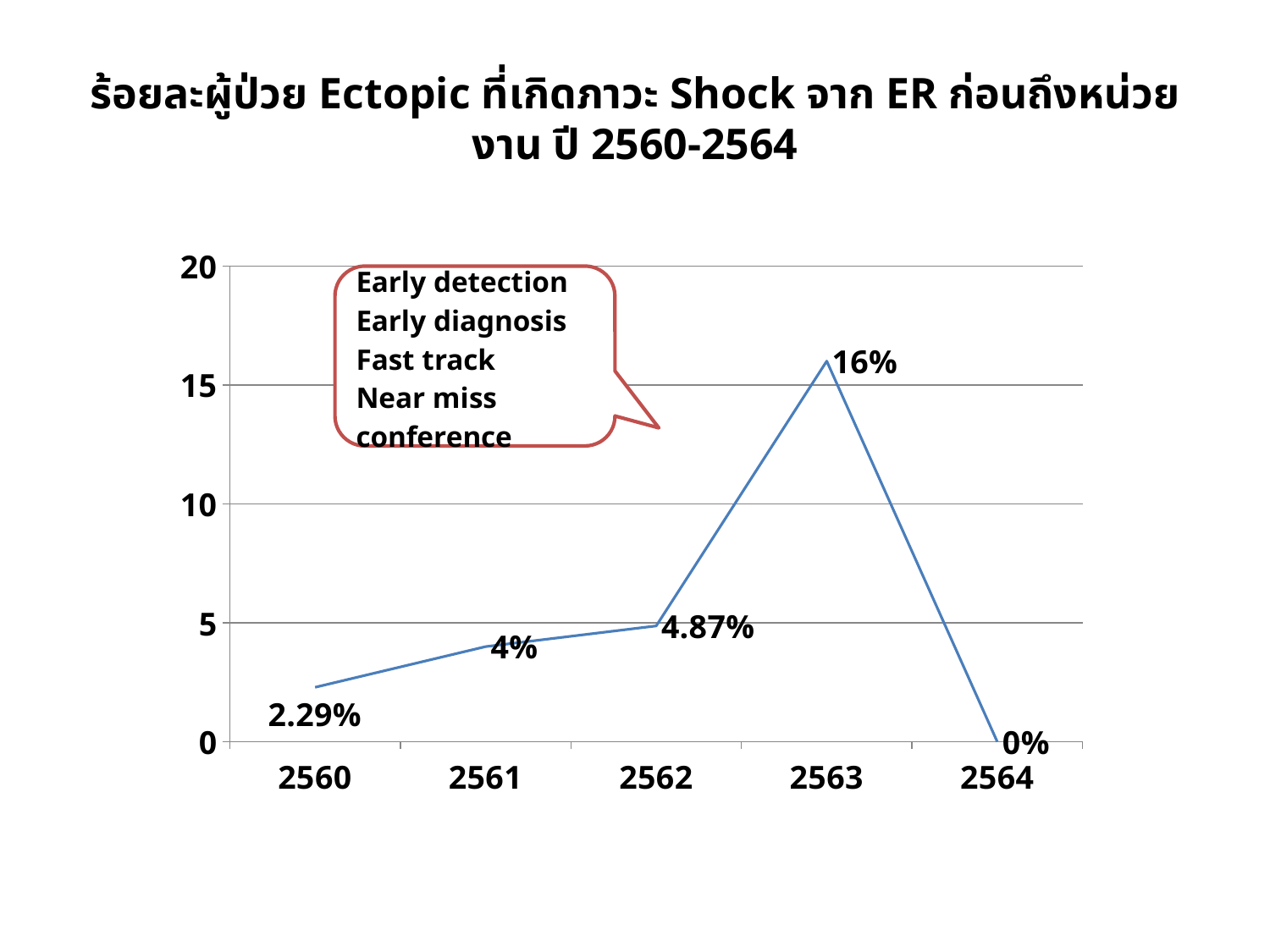
Which year has the highest value? 2563 Is the value for 2563 greater or less than 15? greater Which year has the lowest value? 2564 What is the difference between the values for 2563 and 2562? 11.13% What is the value for 2564? 0% What kind of chart is shown on the slide? line chart Which is larger, the value for 2561 or the value for 2560? 2561 Does the value rise or fall from 2563 to 2564? fall What is the value for 2563? 16% How many years are plotted on the x axis? 5 What is the value for 2562? 4.87% What is the value for 2560? 2.29%